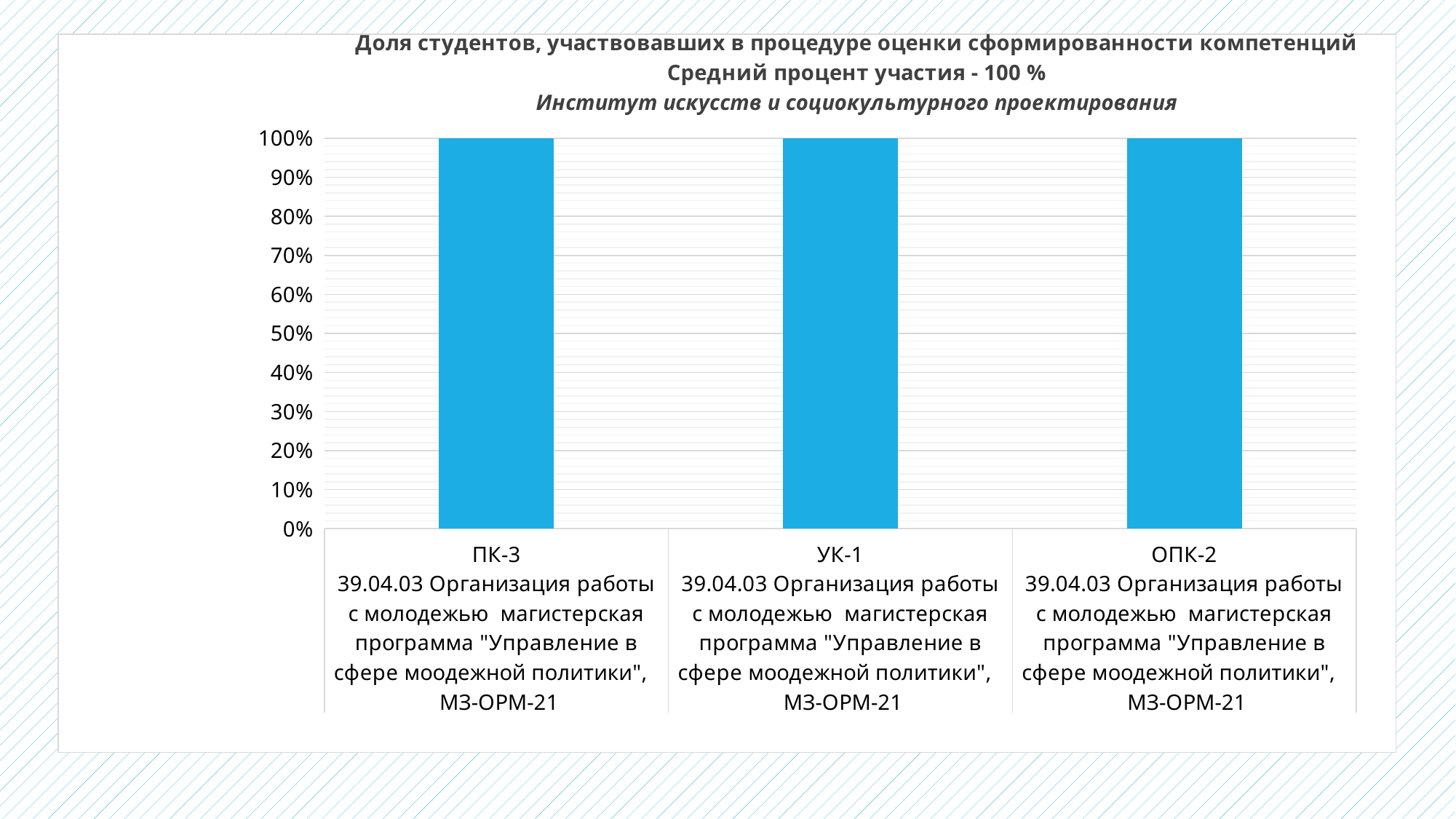
Which institute is named in the chart title? Институт искусств и социокультурного проектирования Is the value for ОПК-2 greater or less than 90%? greater What is the value for УК-1? 100% What is the difference between the values for ПК-3 and ОПК-2? 0% How many bars (categories) does the chart show? 3 Is the value for УК-1 greater or less than 50%? greater What is the highest value shown on the vertical axis? 100% What is the value for ПК-3? 100% What kind of chart is shown on the slide? bar chart What is the label of the first (leftmost) category? ПК-3 What is the value for ОПК-2? 100% Do the values rise, fall, or stay the same across the categories from left to right? stay the same